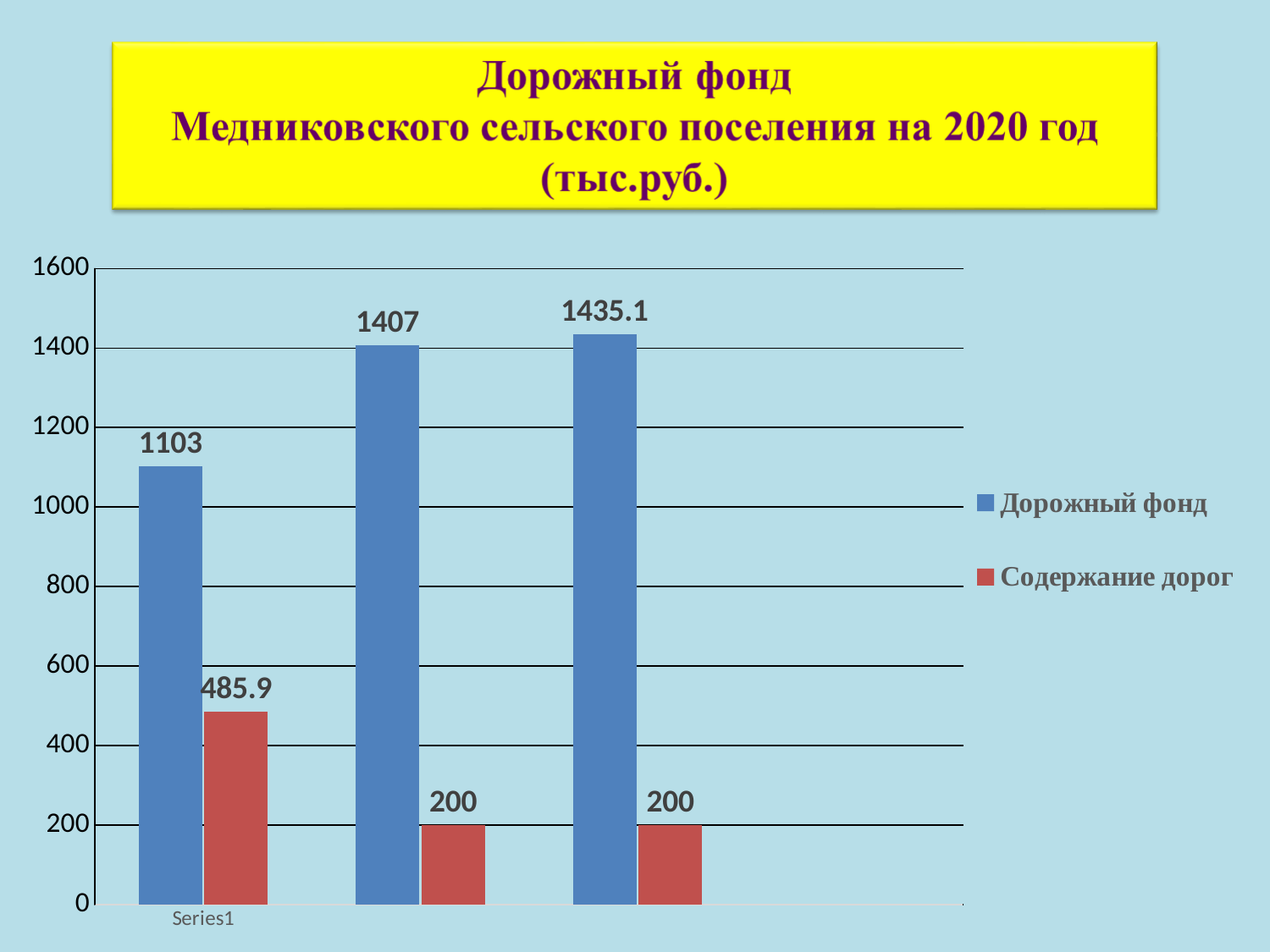
How many series does the legend list? 2 What is the value of the Содержание дорог bar in the second (middle) group? 200 What is the value of the Содержание дорог bar in the first (leftmost) group? 485.9 Do the Дорожный фонд values rise or fall from left to right across the groups? rise What is the difference between the Дорожный фонд values in the second and first groups? 304 What is the value of the Дорожный фонд bar in the first (leftmost) group? 1103 Which group has the highest Дорожный фонд value? the third (rightmost) group How many groups of bars are plotted in the chart? 3 Which group has the lowest Дорожный фонд value? the first (leftmost) group What type of chart is shown on the slide? bar chart What is the value of the Дорожный фонд bar in the third (rightmost) group? 1435.1 Which is larger in the first group: the Дорожный фонд bar or the Содержание дорог bar? Дорожный фонд